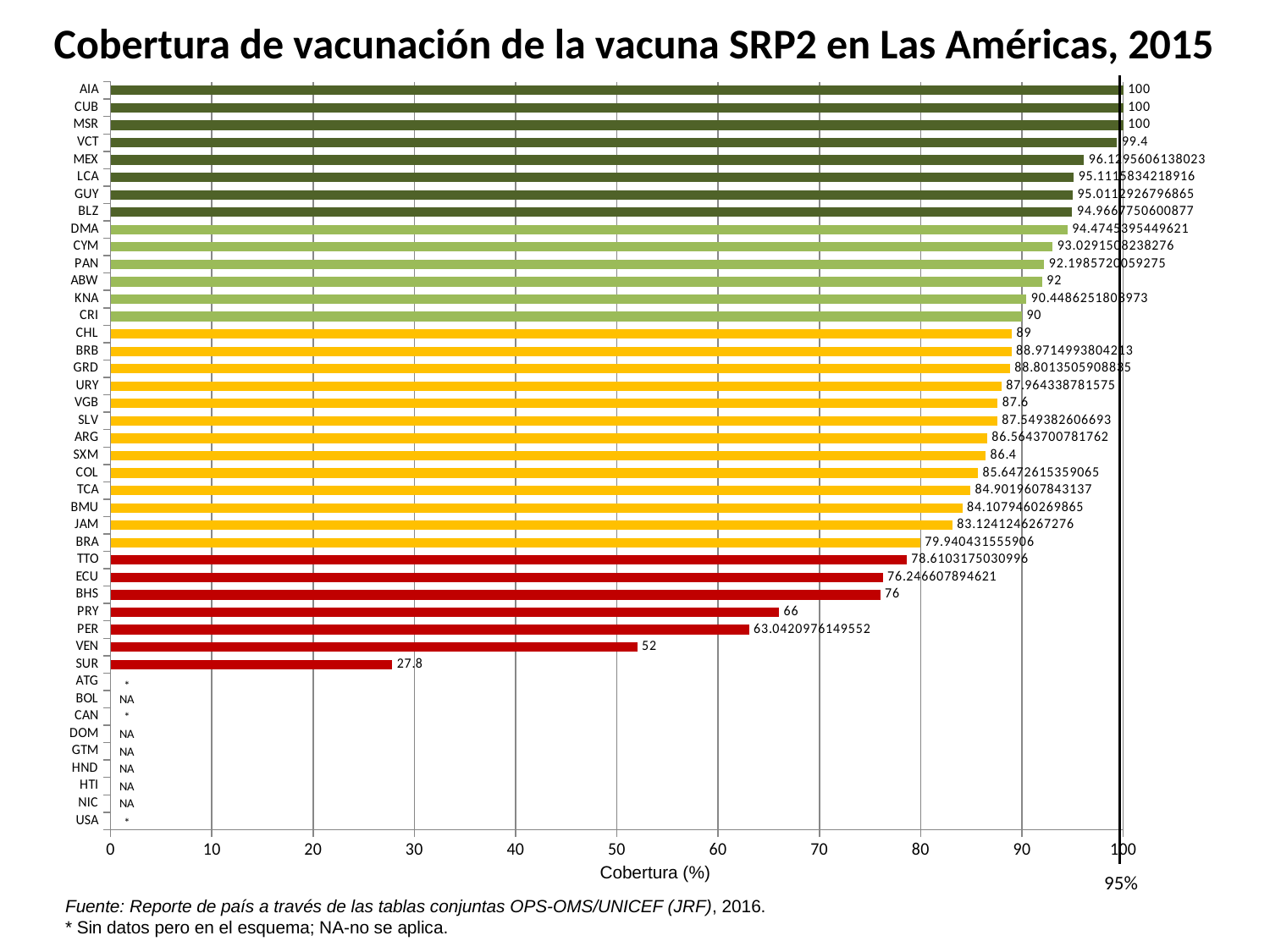
How many countries have a coverage value of exactly 100? 3 What is the coverage value shown for PRY? 66 What is the coverage value shown for VGB? 87.6 What is the SRP2 coverage value shown for VCT? 99.4 What is the coverage value shown for SUR? 27.8 Is the coverage value for TTO greater or less than 80? less Which has a higher coverage value, PRY or VEN? PRY Which country has the lowest plotted coverage value? SUR What is the label of the horizontal axis? Cobertura (%) What is the difference between the coverage values of BHS and PRY? 10 What is the difference between the coverage values of VEN and SUR? 24.2 What type of chart is shown on the slide? bar chart